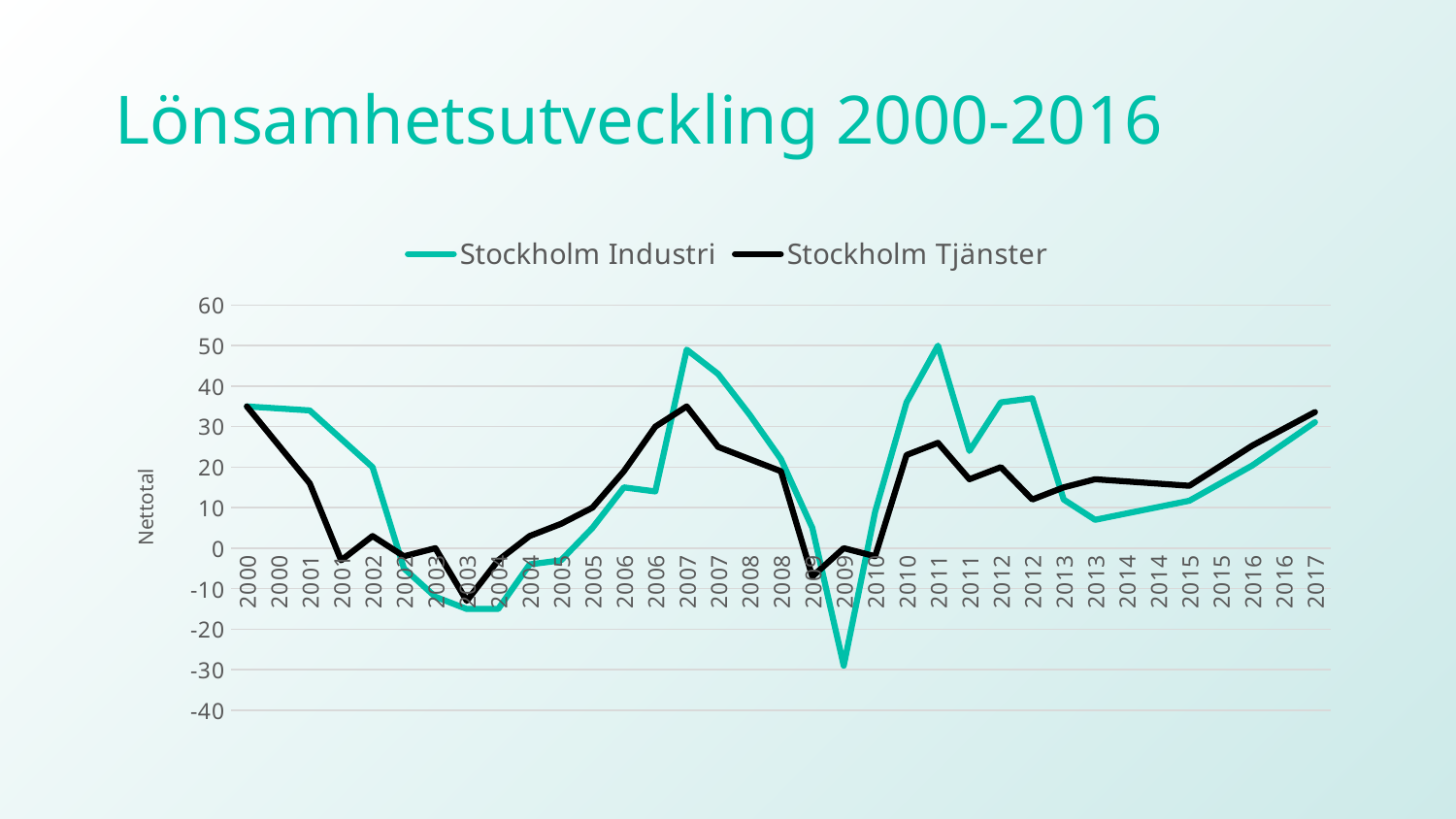
What label is shown on the vertical axis? Nettotal At the second 2009 point, which series has the higher value, Stockholm Industri or Stockholm Tjänster? Stockholm Tjänster Is the value for Stockholm Industri at the first 2007 point greater or less than 40? greater Is the value for Stockholm Tjänster at the first 2007 point greater or less than 30? greater What kind of chart is shown on the slide? line chart At the first 2007 point, which series has the higher value, Stockholm Industri or Stockholm Tjänster? Stockholm Industri Is the value for Stockholm Industri at the first 2011 point greater or less than 40? greater How many series does the legend list? 2 What is the title of the chart on the slide? Lönsamhetsutveckling 2000-2016 Does the Stockholm Industri line rise or fall from the first 2013 point to 2017? rise